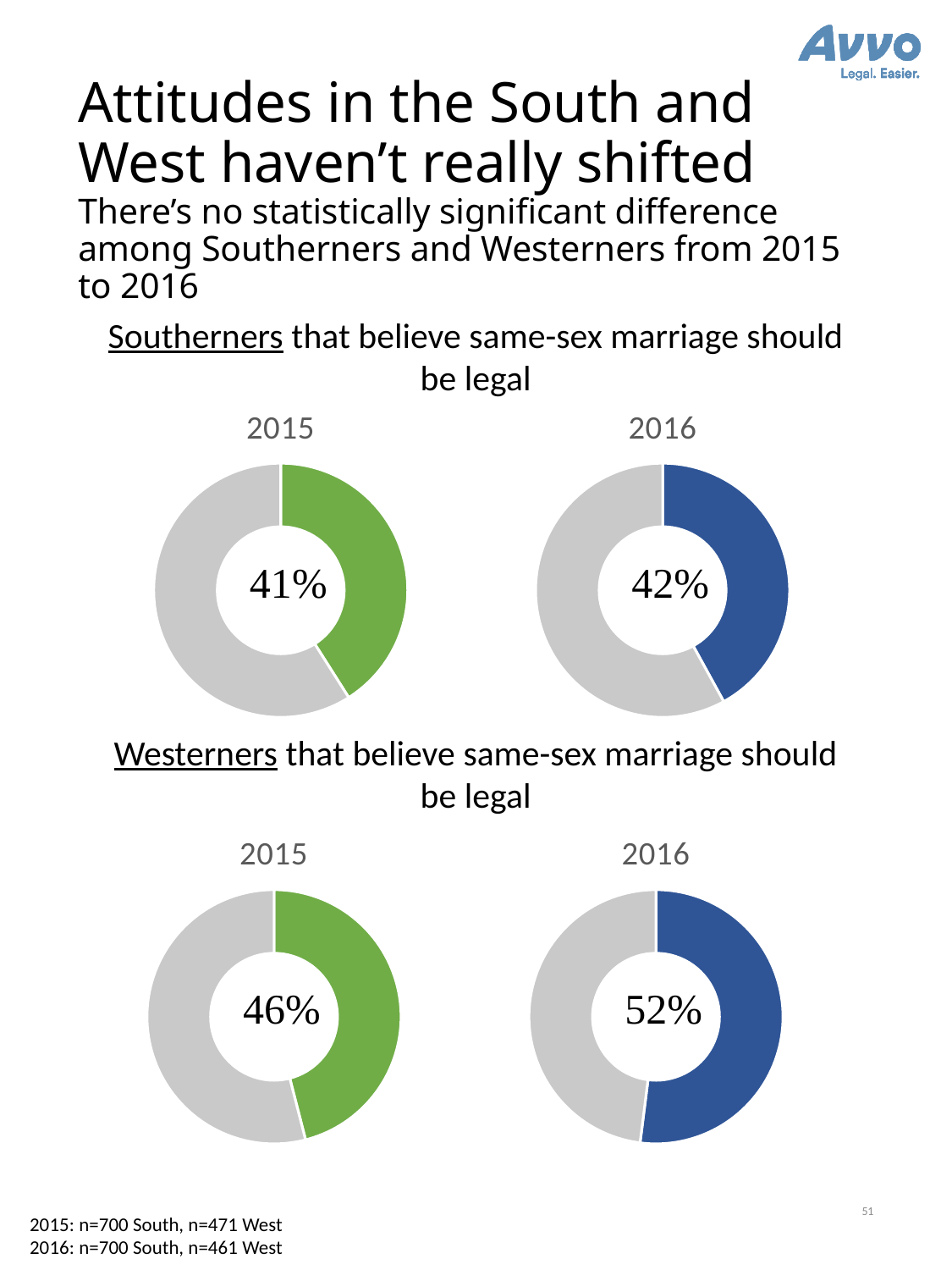
In the Westerners chart, what percentage believed same-sex marriage should be legal in 2015? 46% In the Southerners chart, by how many percentage points did the share change from 2015 to 2016? 1 What colour is the highlighted slice in the 2016 donut charts? Blue Which group had the higher share believing same-sex marriage should be legal in 2016, Southerners or Westerners? Westerners In the Southerners chart, what percentage believed same-sex marriage should be legal in 2016? 42% In the Westerners chart, by how many percentage points did the share rise from 2015 to 2016? 6 In the Southerners chart, what percentage believed same-sex marriage should be legal in 2015? 41% In the Westerners chart, which year has the larger share believing same-sex marriage should be legal, 2015 or 2016? 2016 In the Westerners chart, what percentage believed same-sex marriage should be legal in 2016? 52% What kind of chart is used to show the percentages on this slide? Donut (pie) chart Which of the four donut charts shows the highest percentage? Westerners 2016 Which of the four donut charts shows the lowest percentage? Southerners 2015